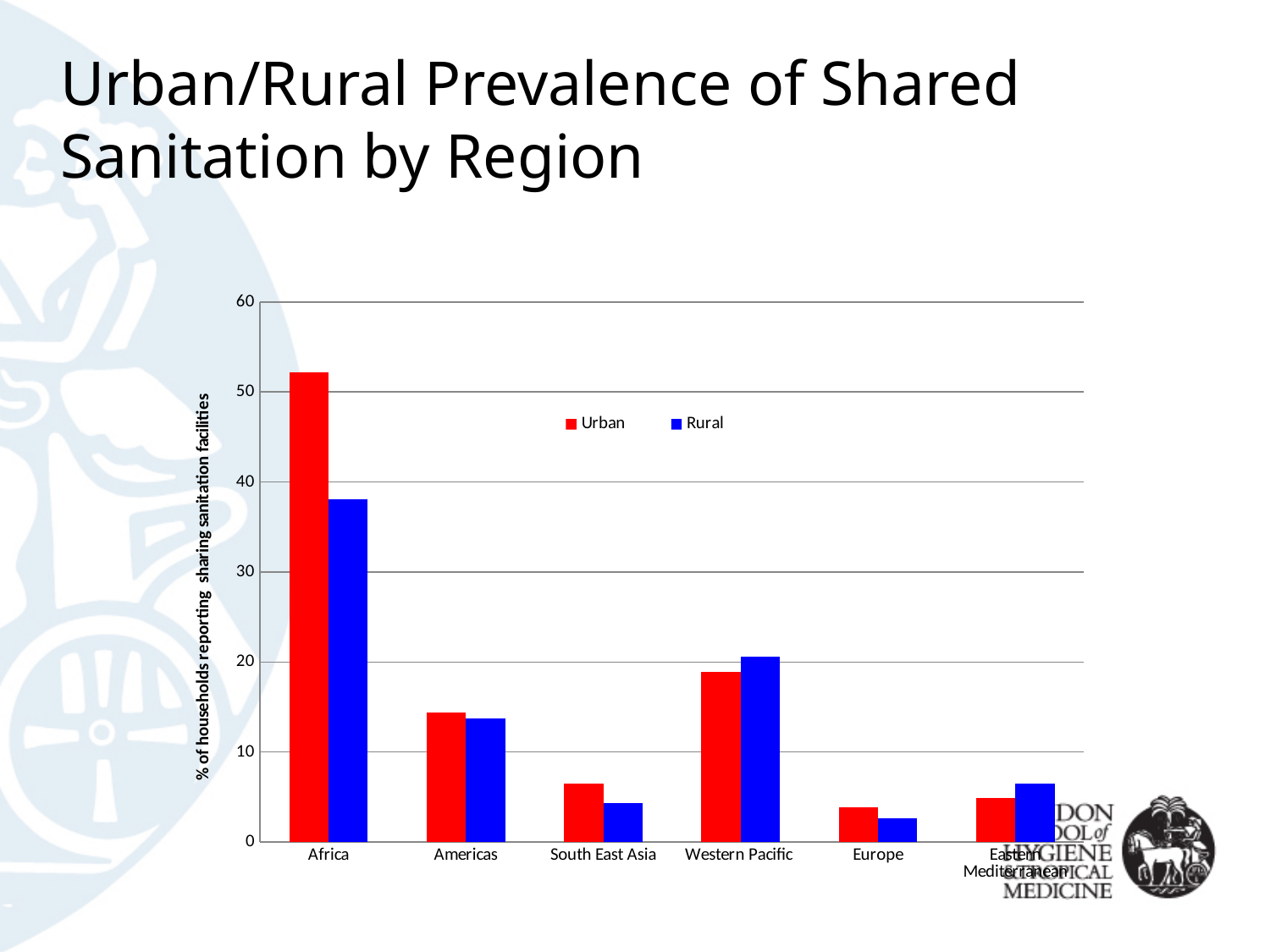
Is the Rural value for Africa greater or less than 40? less What colour are the Rural bars in the chart? blue Is the Urban value for Europe greater or less than 10? less How many regions are shown on the x axis of the chart? 6 For Western Pacific, which is larger, the Urban value or the Rural value? Rural Is the Urban value for Africa greater or less than 50? greater Which region has the lowest Urban value? Europe Which region has the highest Urban value? Africa Which region has the lowest Rural value? Europe What kind of chart is shown on the slide? bar chart For Africa, which is larger, the Urban value or the Rural value? Urban How many series does the chart's legend list? 2